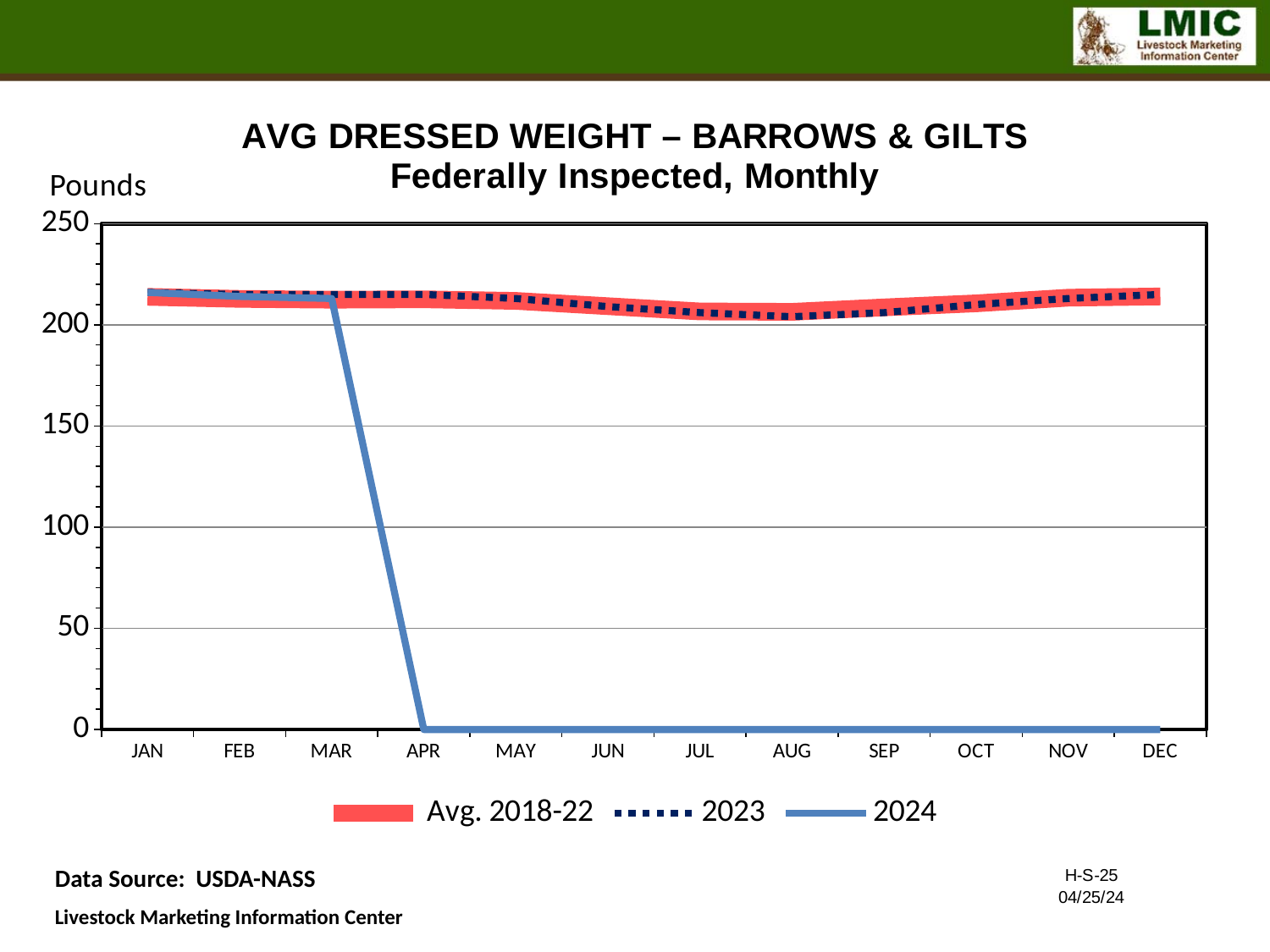
What kind of chart is shown on the slide? line chart How many series does the legend list? 3 Is the value for 2023 in JAN greater or less than 200? greater What unit is shown on the y axis? Pounds Is the value for 2024 in JAN greater or less than 200? greater Is the value for Avg. 2018-22 in AUG greater or less than 200? greater Which is larger for the 2023 series: the value in JAN or the value in AUG? JAN What is the title of the chart? AVG DRESSED WEIGHT – BARROWS & GILTS Federally Inspected, Monthly How many months are shown along the x axis? 12